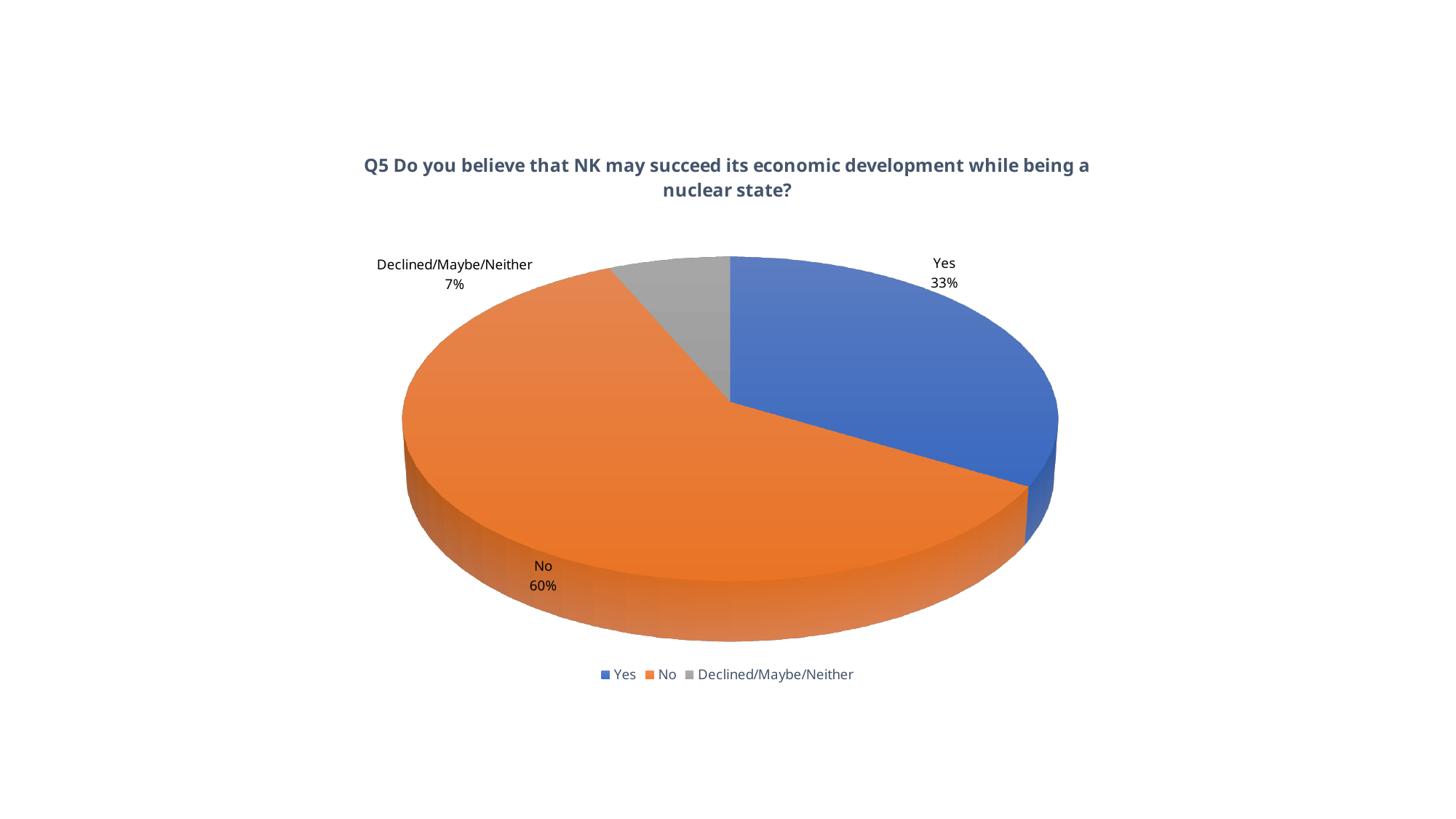
What colour is the "No" slice? Orange Which is larger, the share for "Yes" or the share for "Declined/Maybe/Neither"? Yes What is the difference in percentage points between the "No" and "Yes" shares? 27 Which response has the smallest share of the pie? Declined/Maybe/Neither What is the title of the chart? Q5 Do you believe that NK may succeed its economic development while being a nuclear state? What percentage of respondents answered "No"? 60% How many entries does the legend list? 3 What percentage of respondents answered "Yes"? 33% Which response has the largest share of the pie? No How many slices does the pie chart have? 3 What percentage is shown for "Declined/Maybe/Neither"? 7% What kind of chart is shown on the slide? Pie chart